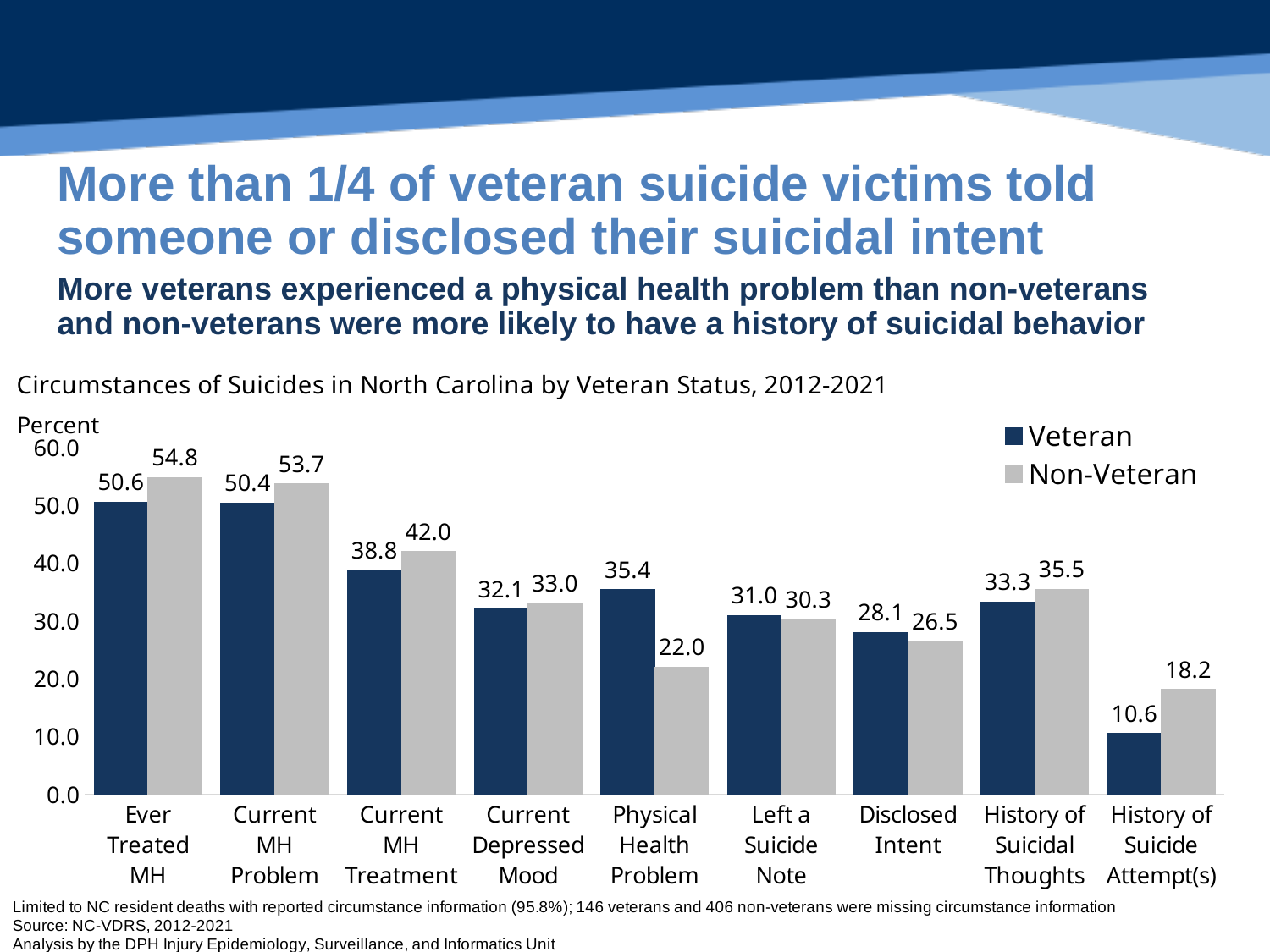
What is the Veteran value for Disclosed Intent? 28.1 For Left a Suicide Note, which is larger: the Veteran or Non-Veteran value? Veteran How many categories are shown on the x axis? 9 Which category has the lowest Veteran value? History of Suicide Attempt(s) What is the title of the chart? Circumstances of Suicides in North Carolina by Veteran Status, 2012-2021 How many series does the legend list? 2 What is the difference between the Veteran and Non-Veteran values for Physical Health Problem? 13.4 What is the Non-Veteran value for History of Suicide Attempt(s)? 18.2 What kind of chart is shown on the slide? Bar chart What is the Veteran value for Physical Health Problem? 35.4 What is the difference between the Non-Veteran and Veteran values for History of Suicide Attempt(s)? 7.6 Which category has the highest Non-Veteran value? Ever Treated MH